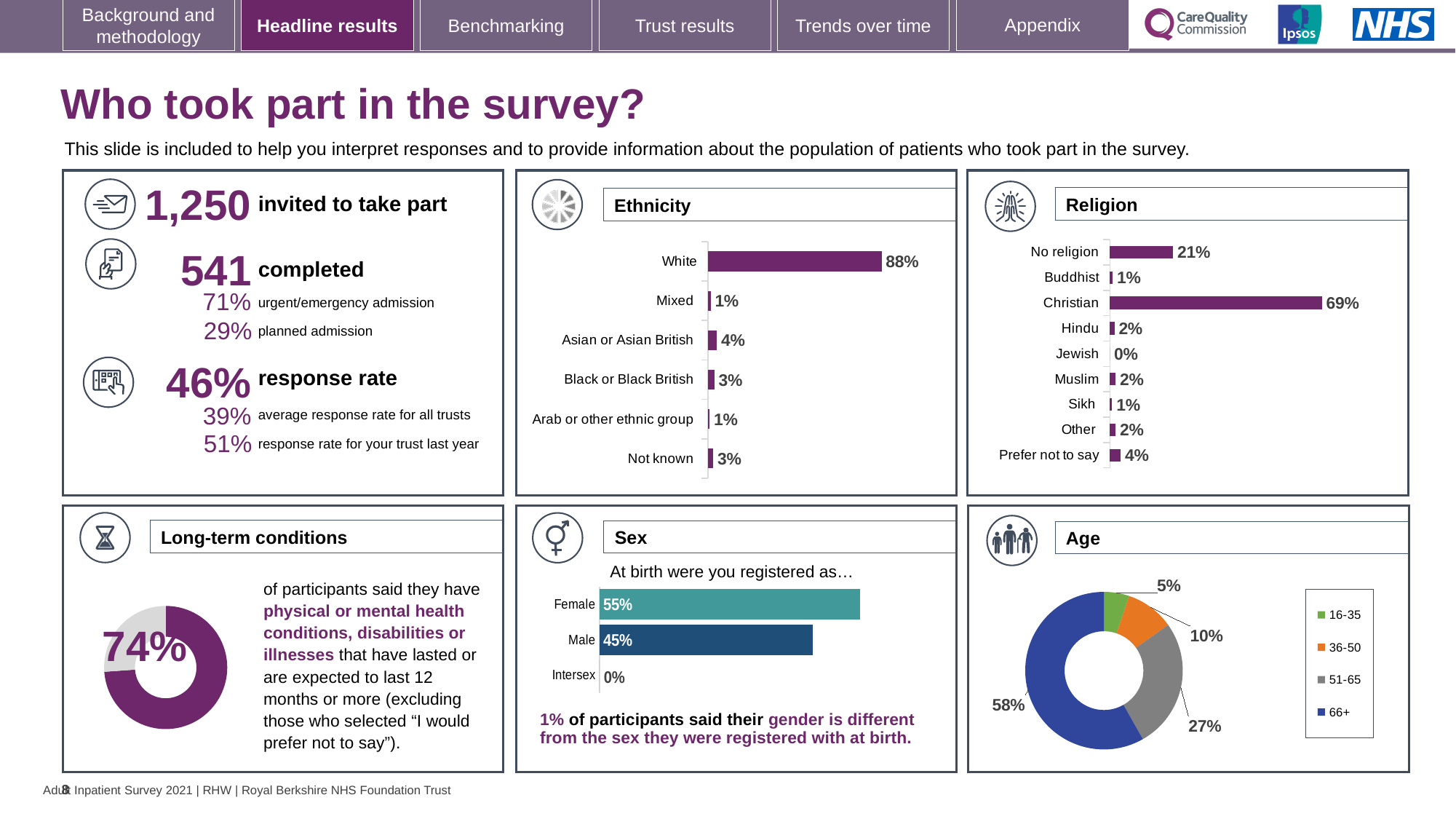
In the Age chart, what share of participants were aged 66+? 58% How many entries does the legend of the Age chart list? 4 How many categories does the Ethnicity chart show? 6 In the Religion chart, what is the difference between the values for Christian and No religion? 48% What kind of chart is the Age chart? Doughnut chart In the Ethnicity chart, what is the difference between the values for Asian or Asian British and Black or Black British? 1% In the Sex chart, what percentage of participants were registered as Male at birth? 45% In the Ethnicity chart, which category has the highest value? White In the Religion chart, which category has the lowest value? Jewish In the Sex chart, which is larger, Female or Male? Female In the Religion chart, what percentage of participants were Christian? 69% In the Ethnicity chart, what percentage of participants were White? 88%